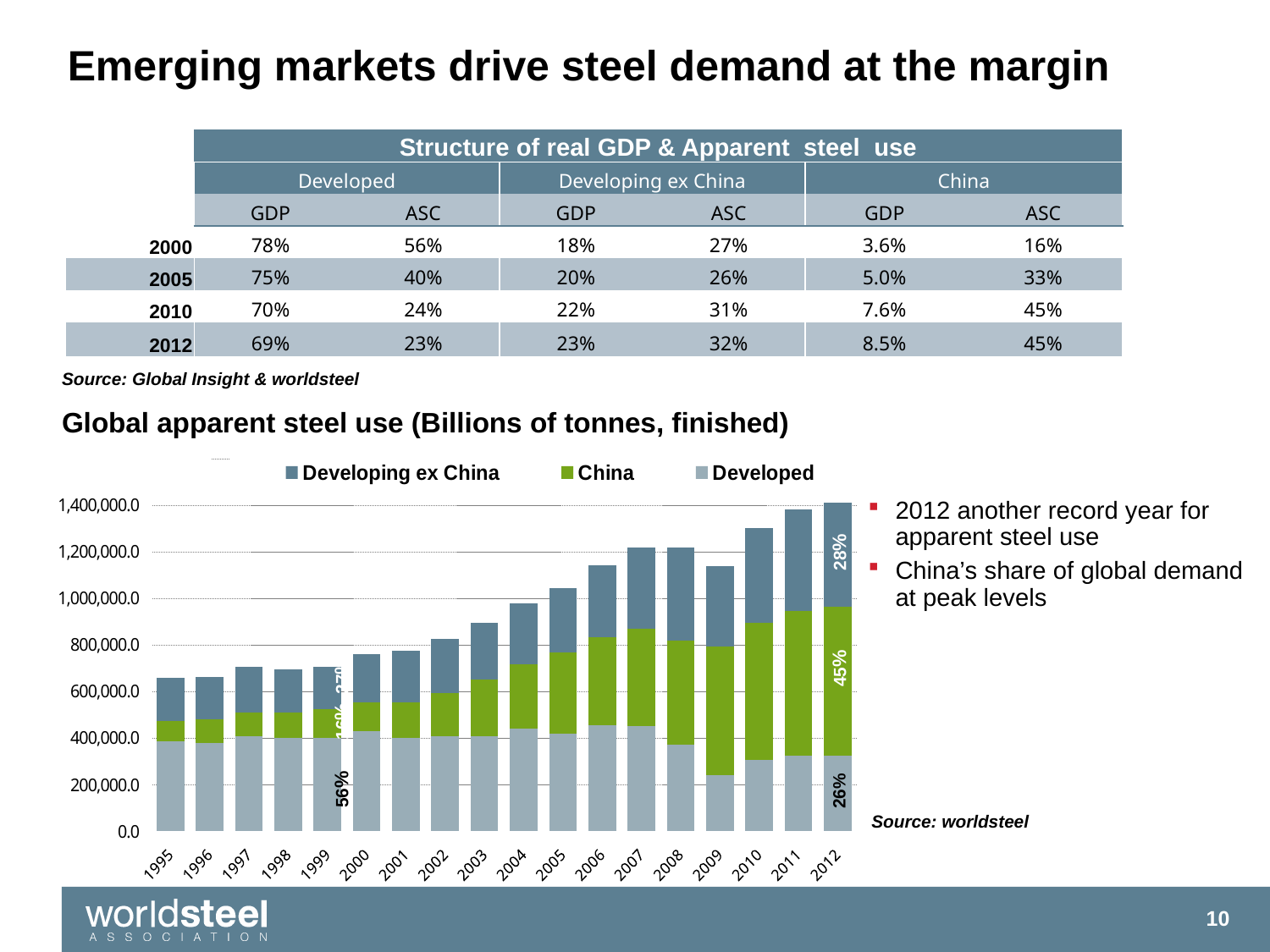
In the 'Global apparent steel use' chart, which year has the highest total bar? 2012 In the 'Global apparent steel use' chart, do the total bars generally rise or fall from 1995 to 2012? Rise In the 'Global apparent steel use' chart, what share is labelled on the Developed segment of the 1999 bar? 56% In the 'Global apparent steel use' chart, is the total for 2010 greater or less than 1,200,000.0? greater In the 'Global apparent steel use' chart, is the total for 1995 greater or less than 800,000.0? less In the 'Global apparent steel use' chart, what share is labelled on the Developing ex China segment of the 2012 bar? 28% In the 'Global apparent steel use' chart, what share is labelled on the Developed segment of the 2012 bar? 26% In the 'Global apparent steel use' chart, by how many percentage points does the China share label exceed the Developed share label in the 2012 bar? 19 percentage points How many series does the legend of the 'Global apparent steel use' chart list? 3 What kind of chart is the 'Global apparent steel use' chart? Stacked bar chart In the 'Global apparent steel use' chart, what share is labelled on the China segment of the 2012 bar? 45% How many years are shown on the x axis of the 'Global apparent steel use' chart? 18